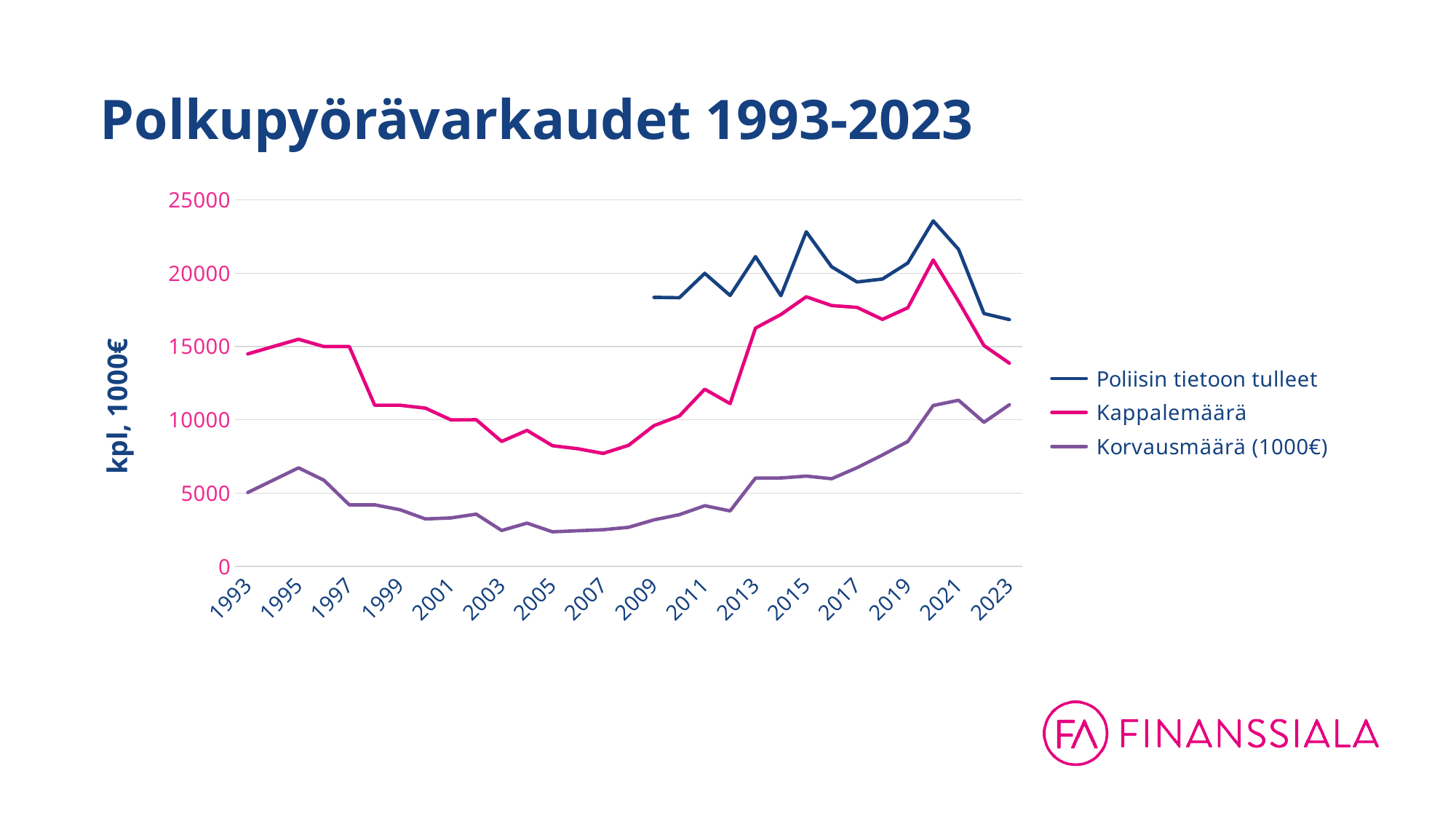
Is the value for Poliisin tietoon tulleet in 2020 greater or less than 20000? greater Is the value for Korvausmäärä (1000€) in 2005 greater or less than 5000? less Does Kappalemäärä rise or fall from 2020 to 2023? fall In which year does Kappalemäärä reach its highest value? 2020 What is the title of the chart? Polkupyörävarkaudet 1993-2023 Is the value for Kappalemäärä in 1993 greater or less than 10000? greater In 2023, which is larger: Poliisin tietoon tulleet or Kappalemäärä? Poliisin tietoon tulleet What kind of chart is shown on the slide? line chart How many series does the legend list? 3 In 1995, which is larger: Kappalemäärä or Korvausmäärä (1000€)? Kappalemäärä Which series only begins in 2009 rather than 1993? Poliisin tietoon tulleet